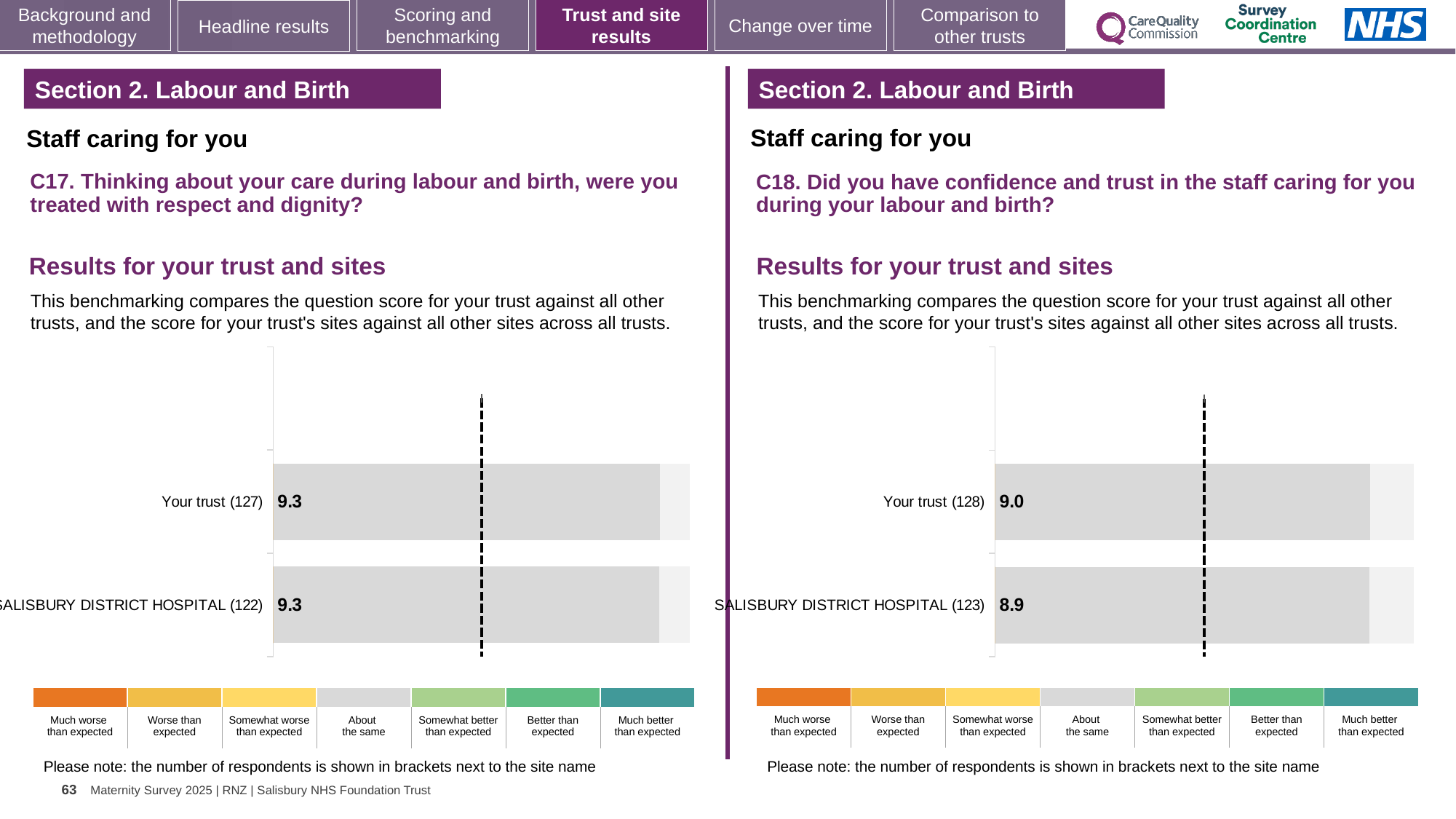
In the C18 chart on the right, which has the higher score, Your trust or SALISBURY DISTRICT HOSPITAL? Your trust In the C18 chart on the right, what is the score for SALISBURY DISTRICT HOSPITAL? 8.9 In the C18 chart on the right, which category has the lowest score? SALISBURY DISTRICT HOSPITAL In the C17 chart on the left, is the score for Your trust greater or less than the score for SALISBURY DISTRICT HOSPITAL, or are they equal? Equal In the C18 chart on the right, how many respondents are shown in brackets for SALISBURY DISTRICT HOSPITAL? 123 In the C17 chart on the left, what is the score for Your trust? 9.3 In the C18 chart on the right, what is the score for Your trust? 9.0 In the C18 chart on the right, what is the difference between the Your trust score and the SALISBURY DISTRICT HOSPITAL score? 0.1 What type of chart is used for the C18 results on the right? Bar chart In the C17 chart on the left, what is the score for SALISBURY DISTRICT HOSPITAL? 9.3 In the C17 chart on the left, how many respondents are shown in brackets for Your trust? 127 How many bars are plotted in the C17 chart on the left? 2